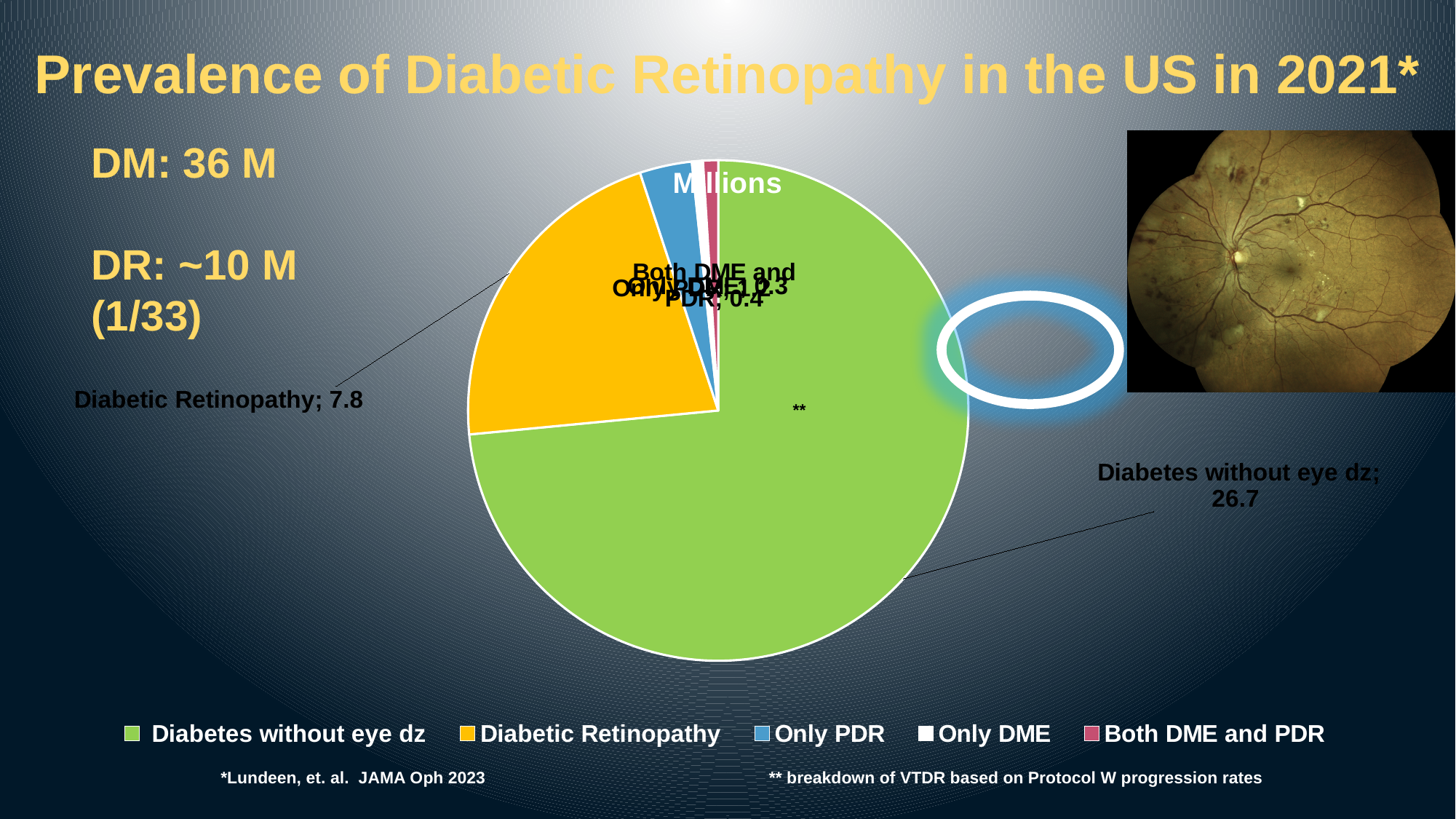
What is the value for Diabetic Retinopathy in the pie chart? 7.8 Which category has the largest slice in the pie chart? Diabetes without eye dz What type of chart is shown on the slide? Pie chart How many categories does the pie chart legend list? 5 What is the title of the pie chart? Millions Which is larger, the value for Diabetic Retinopathy or the value for Both DME and PDR? Diabetic Retinopathy What is the difference between the values for Diabetes without eye dz and Diabetic Retinopathy? 18.9 What colour is the Diabetic Retinopathy slice in the pie chart? Yellow Which is larger, the slice for Diabetes without eye dz or the slice for Diabetic Retinopathy? Diabetes without eye dz What is the value for Both DME and PDR in the pie chart? 0.4 What is the value for Diabetes without eye dz in the pie chart? 26.7